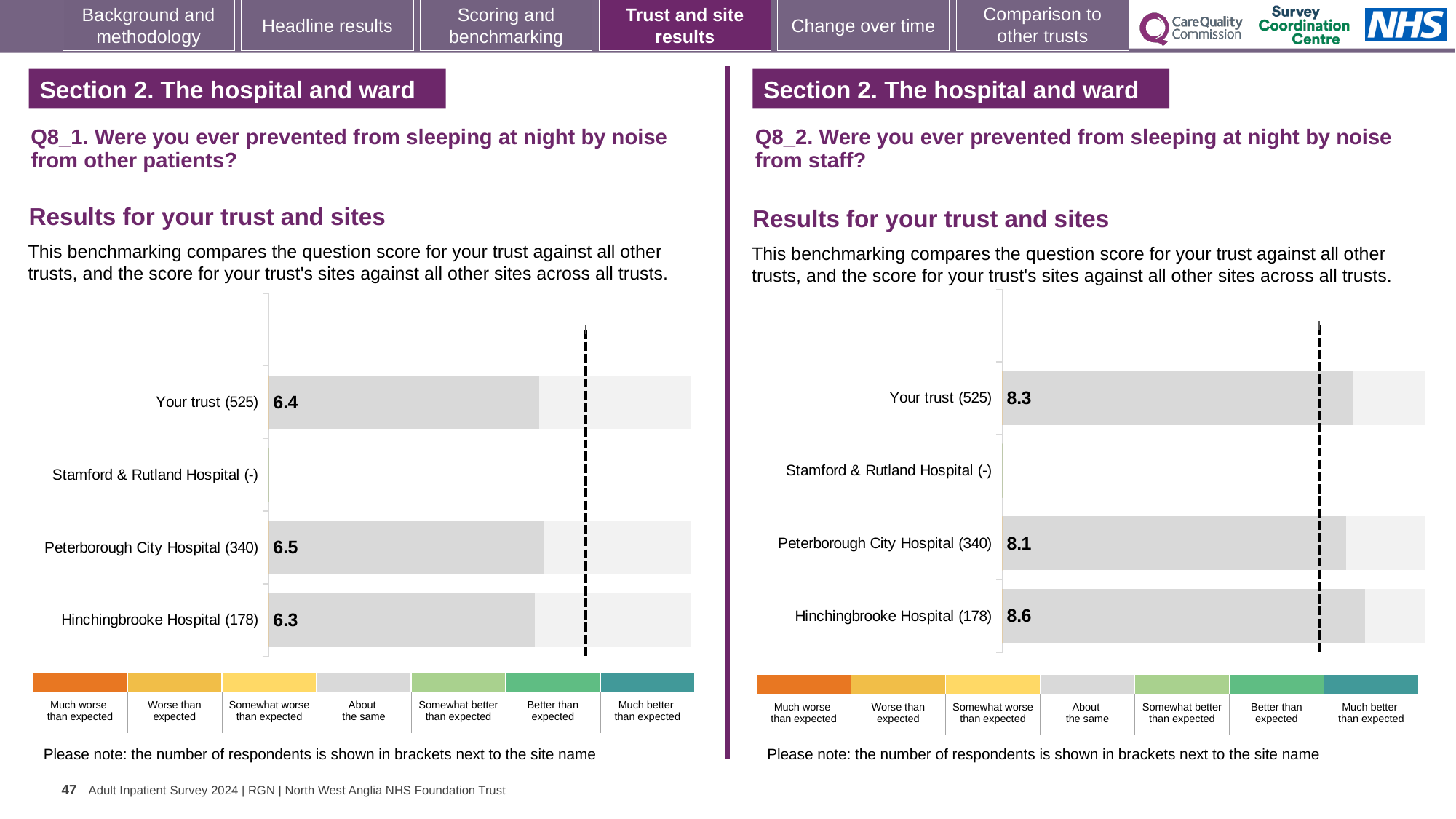
On the Q8_1 chart (noise from other patients), what is the score for Your trust (525)? 6.4 On the Q8_2 chart (noise from staff), what is the score for Peterborough City Hospital (340)? 8.1 On the Q8_1 chart (noise from other patients), what is the difference between the scores for Peterborough City Hospital and Hinchingbrooke Hospital? 0.2 On the Q8_1 chart (noise from other patients), which site has the highest score? Peterborough City Hospital (340) What kind of chart is used on the Q8_1 chart (noise from other patients)? Bar chart On the Q8_2 chart (noise from staff), what is the score for Your trust (525)? 8.3 On the Q8_2 chart (noise from staff), what is the difference between the scores for Hinchingbrooke Hospital and Peterborough City Hospital? 0.5 On the Q8_1 chart (noise from other patients), what is the score for Hinchingbrooke Hospital (178)? 6.3 On the Q8_2 chart (noise from staff), which site has the lowest score among those with a value shown? Peterborough City Hospital (340) On the Q8_2 chart (noise from staff), is the score for Hinchingbrooke Hospital larger or smaller than the score for Your trust? larger On the Q8_2 chart (noise from staff), what is the score for Hinchingbrooke Hospital (178)? 8.6 On the Q8_1 chart (noise from other patients), what is the score for Peterborough City Hospital (340)? 6.5